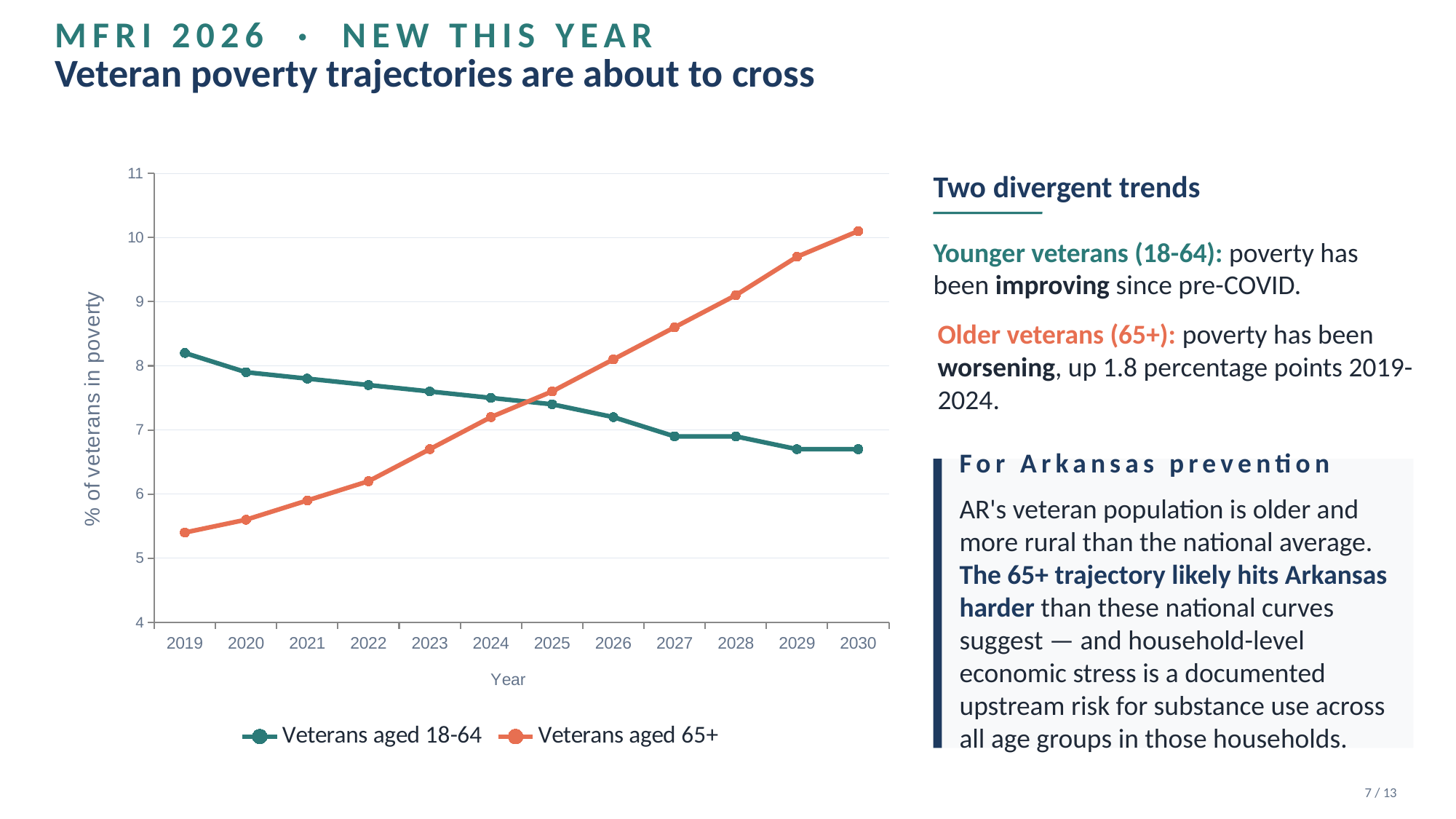
Is the value for Veterans aged 18-64 in 2030 greater or less than 7? less In which year does the Veterans aged 65+ series reach its highest value? 2030 How many years are plotted along the x axis of the chart? 12 In 2030, which series has the higher value, Veterans aged 18-64 or Veterans aged 65+? Veterans aged 65+ Is the value for Veterans aged 65+ in 2019 greater or less than 6? less What kind of chart is shown on the slide? line chart Is the value for Veterans aged 65+ in 2030 greater or less than 9? greater What is the label on the x axis of the chart? Year How many series does the chart's legend list? 2 Does the value for Veterans aged 18-64 rise or fall from 2019 to 2030? fall In 2019, which series has the higher value, Veterans aged 18-64 or Veterans aged 65+? Veterans aged 18-64 Does the value for Veterans aged 65+ rise or fall from 2019 to 2030? rise